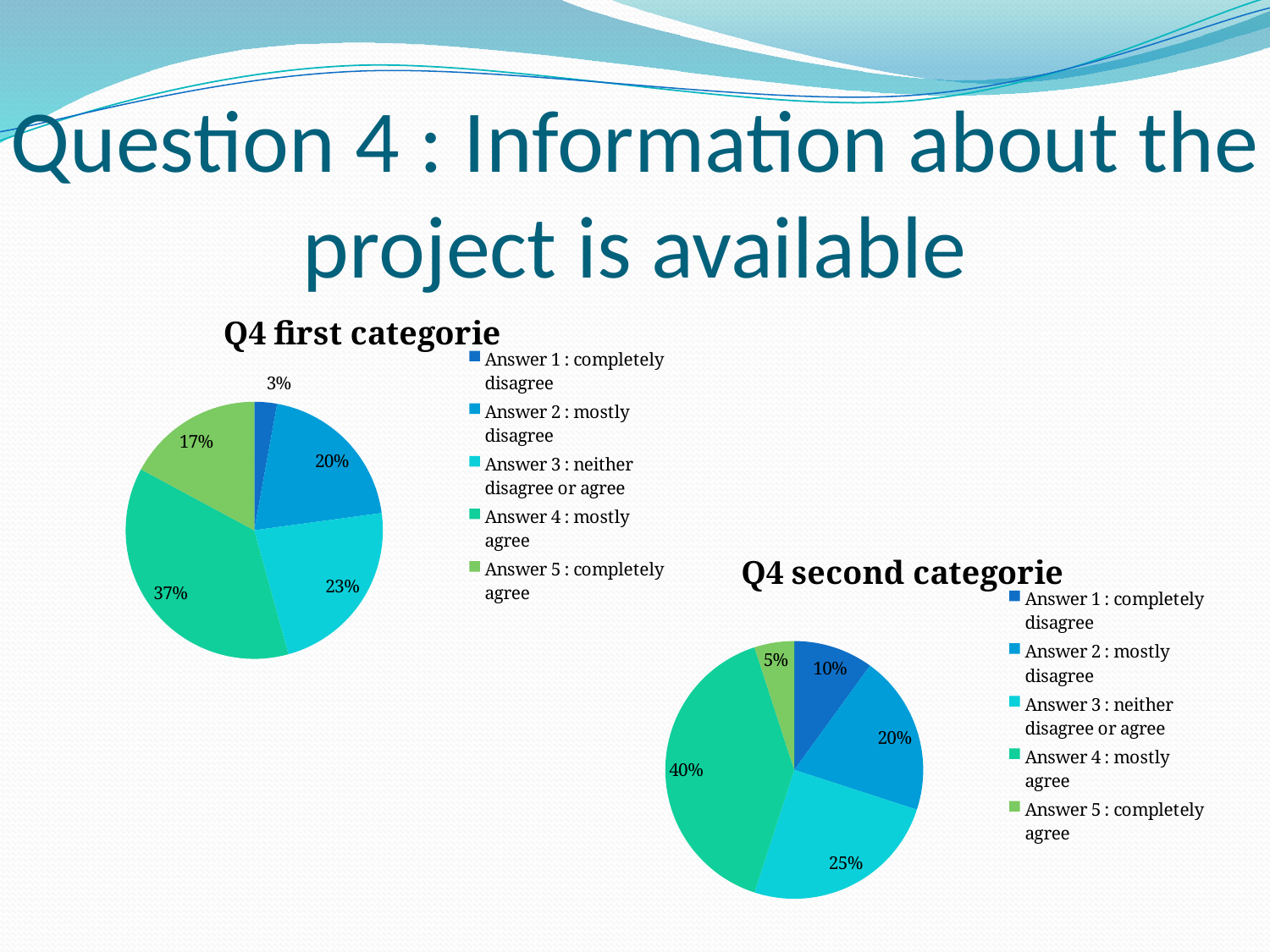
In the 'Q4 second categorie' chart, what share does 'Answer 3 : neither disagree or agree' have? 25% In the 'Q4 second categorie' chart, what share does 'Answer 5 : completely agree' have? 5% In the 'Q4 first categorie' chart, what share does 'Answer 4 : mostly agree' have? 37% What kind of chart is 'Q4 first categorie'? Pie chart In the 'Q4 second categorie' chart, which answer has the smallest slice? Answer 5 : completely agree In the 'Q4 second categorie' chart, which is larger: the share for 'Answer 1 : completely disagree' or 'Answer 2 : mostly disagree'? Answer 2 : mostly disagree In the 'Q4 first categorie' chart, what is the difference between the shares of 'Answer 3 : neither disagree or agree' and 'Answer 2 : mostly disagree'? 3% How many slices does the 'Q4 second categorie' chart have? 5 In the 'Q4 first categorie' chart, which answer has the largest slice? Answer 4 : mostly agree In the 'Q4 first categorie' chart, which answer has the smallest slice? Answer 1 : completely disagree In the 'Q4 second categorie' chart, which answer has the largest slice? Answer 4 : mostly agree